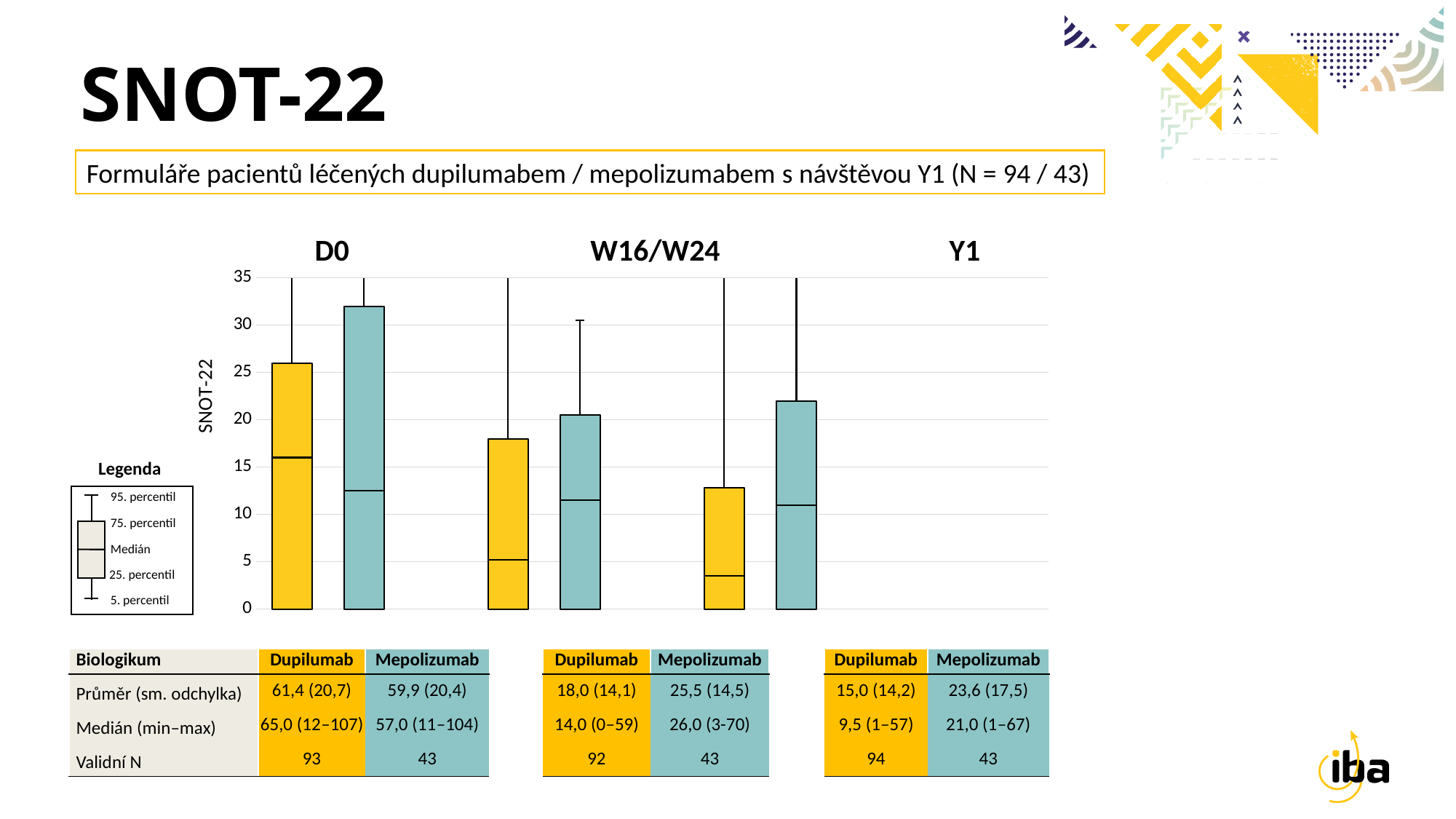
What is the label of the y axis of the chart? SNOT-22 In the chart, is the top of the Mepolizumab box at D0 greater or less than 30? greater According to the table, what is the difference in valid N between Dupilumab and Mepolizumab at Y1? 51 According to the table below the chart, what is the valid N for Dupilumab at Y1? 94 What kind of chart is shown on the slide? Box plot According to the table, does the mean SNOT-22 for Dupilumab rise or fall from D0 to Y1? fall How many treatment groups are compared at each time point in the chart? 2 In the chart, is the median line of the Dupilumab box at W16/W24 greater or less than 10? less How many time points are shown along the x axis of the chart? 3 According to the table below the chart, what is the median (min–max) SNOT-22 for Dupilumab at D0? 65,0 (12–107) According to the table, which group has the larger valid N at D0, Dupilumab or Mepolizumab? Dupilumab According to the table below the chart, what is the mean (SD) SNOT-22 for Mepolizumab at W16/W24? 25,5 (14,5)